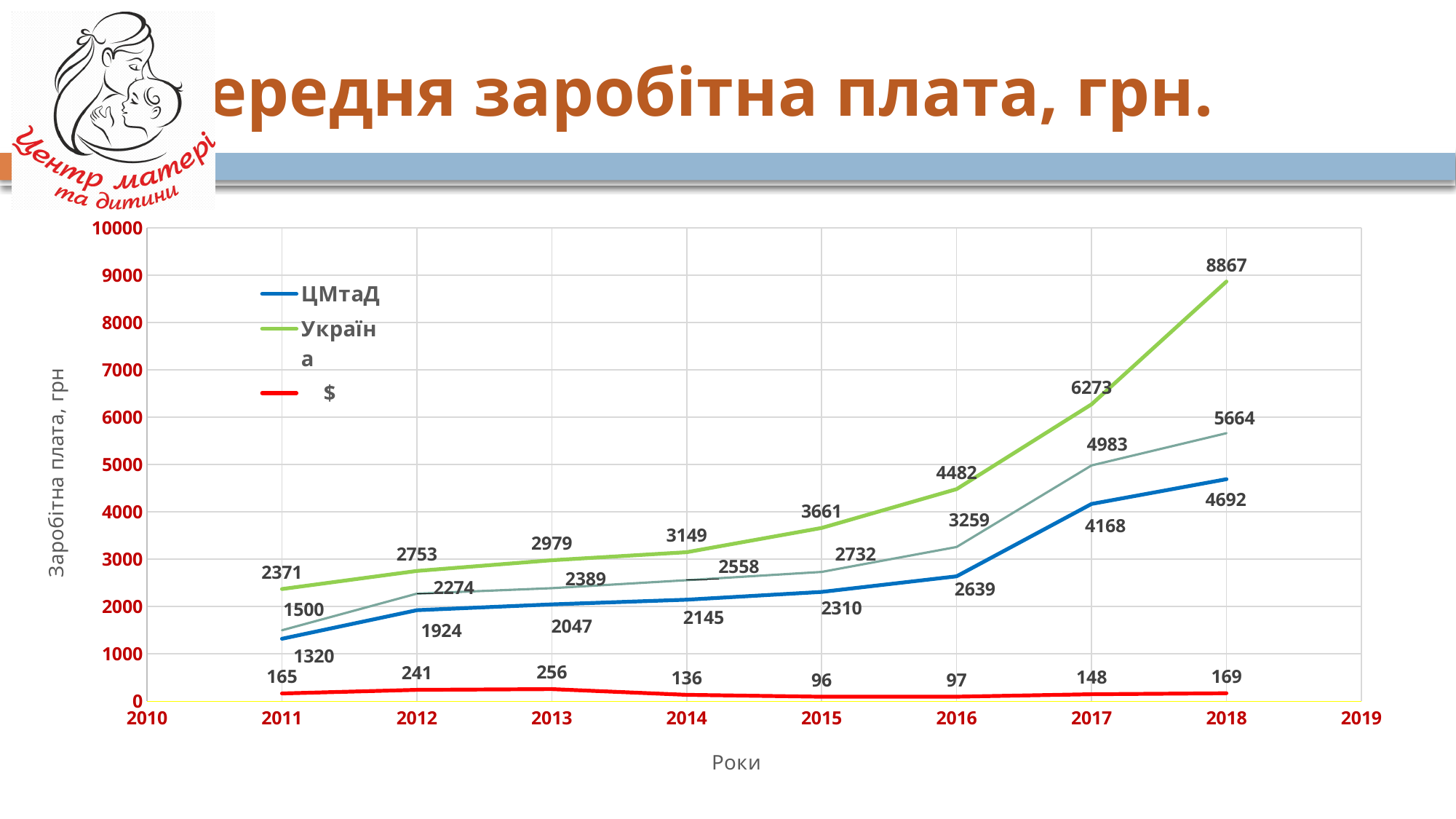
In which year is the ЦМтаД series at its lowest? 2011 What is the value for the $ series in 2015? 96 In which year is the $ series at its highest? 2013 Which is larger in 2017, the ЦМтаД value or the Україна value? Україна How many series does the legend list? 3 Does the Україна series rise or fall from 2011 to 2018? rises What is the value for Україна in 2018? 8867 What is the difference between the Україна value and the ЦМтаД value in 2018? 4175 What kind of chart is shown on the slide? line chart What is the value for ЦМтаД in 2011? 1320 By how much did the ЦМтаД value increase from 2017 to 2018? 524 What is the title of the x axis? Роки